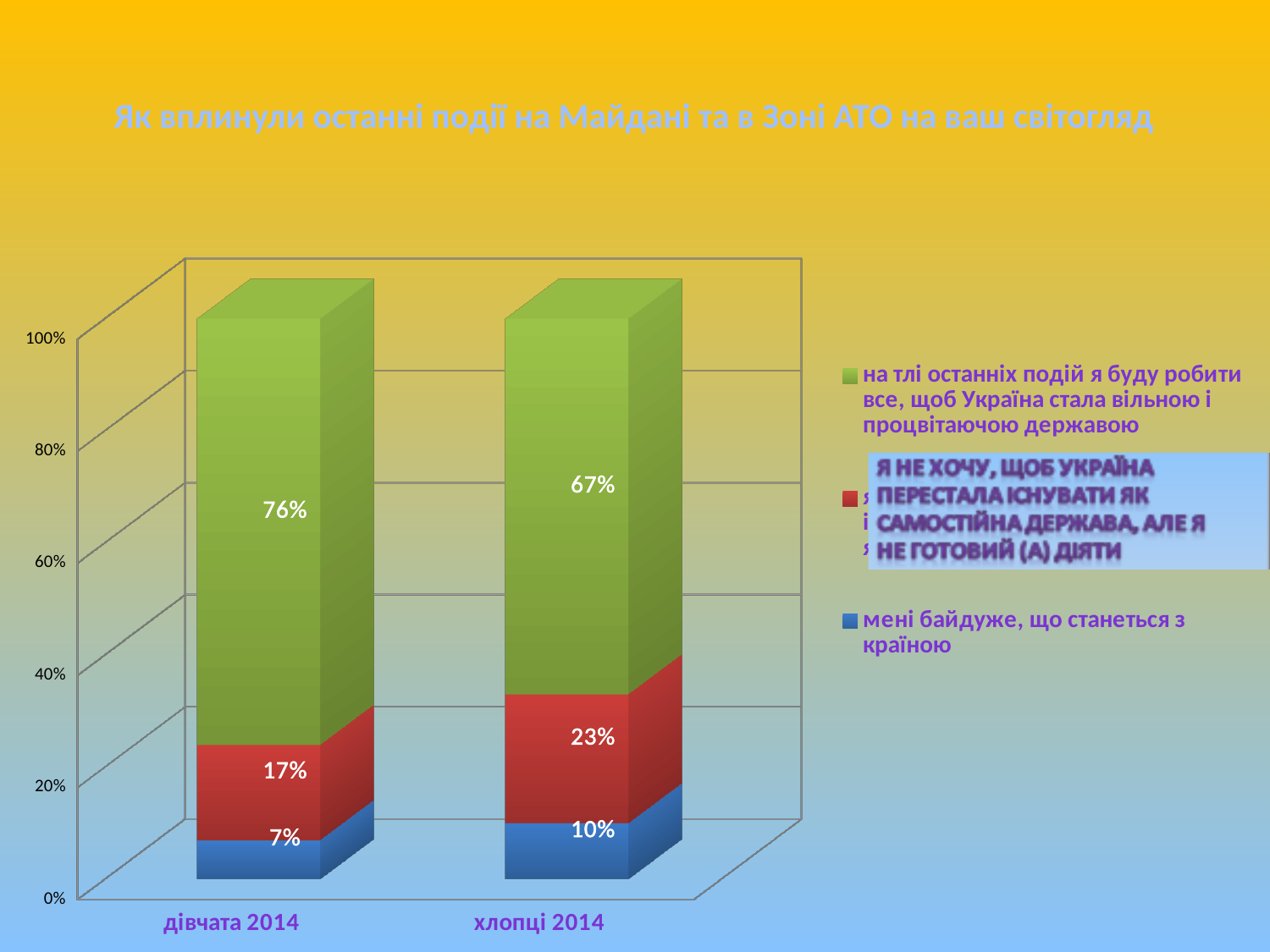
What percentage of дівчата 2014 chose the green option (will do everything so Ukraine becomes a free and prosperous state)? 76% How many series does the legend list? 3 How many categories are shown on the x axis? 2 Which group has the larger green segment, дівчата 2014 or хлопці 2014? дівчата 2014 What type of chart is shown on the slide? Stacked bar chart What percentage of хлопці 2014 chose the green option (will do everything so Ukraine becomes a free and prosperous state)? 67% What percentage of хлопці 2014 said they are indifferent to what happens to the country (blue segment)? 10% What is the value of the red segment for дівчата 2014? 17% What is the difference between the green segment values for дівчата 2014 and хлопці 2014? 9% What is the difference between the red segment values for хлопці 2014 and дівчата 2014? 6% What percentage of дівчата 2014 said they are indifferent to what happens to the country (blue segment)? 7% What is the value of the red segment for хлопці 2014? 23%